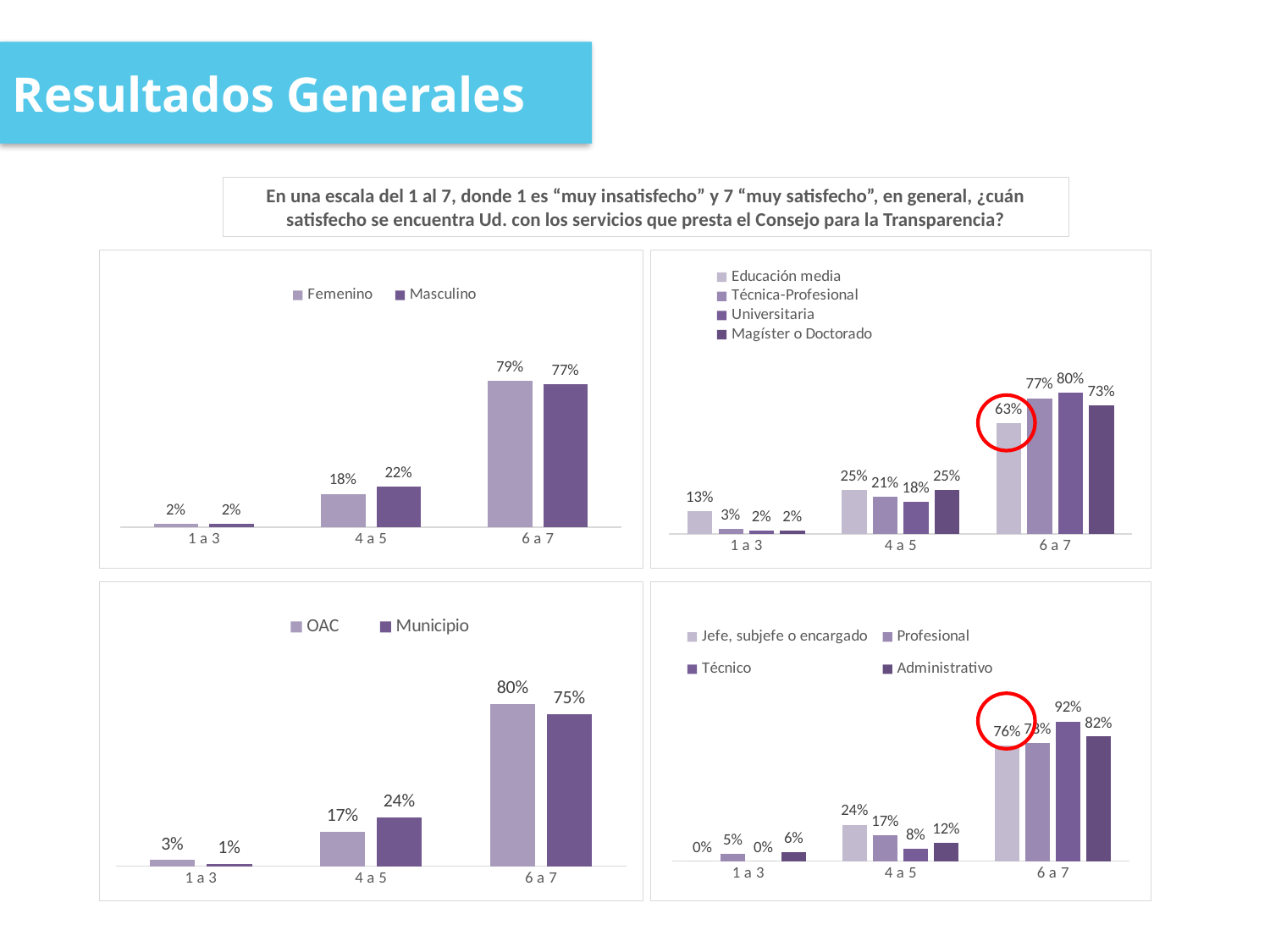
In the bottom-left chart (OAC vs Municipio), what is the value for Municipio in the 4 a 5 category? 24% In the bottom-right chart (job roles), what is the value for Técnico in the 6 a 7 category? 92% In the top-right chart (education levels), which series has the highest value in the 6 a 7 category? Universitaria In the top-left chart (Femenino vs Masculino), how many series does the legend list? 2 In the bottom-right chart (job roles), what is the difference between Jefe, subjefe o encargado and Técnico in the 4 a 5 category? 16% In the bottom-left chart (OAC vs Municipio), which is larger in the 6 a 7 category, OAC or Municipio? OAC In the top-right chart (education levels), which series has the highest value in the 1 a 3 category? Educación media In the top-left chart (Femenino vs Masculino), what is the difference between Masculino and Femenino in the 4 a 5 category? 4% In the top-left chart (Femenino vs Masculino), what is the value for Femenino in the 6 a 7 category? 79% In the top-right chart (education levels), what is the value for Educación media in the 6 a 7 category? 63% What kind of chart is the bottom-left chart (OAC vs Municipio)? Bar chart In the top-right chart (education levels), how many series does the legend list? 4